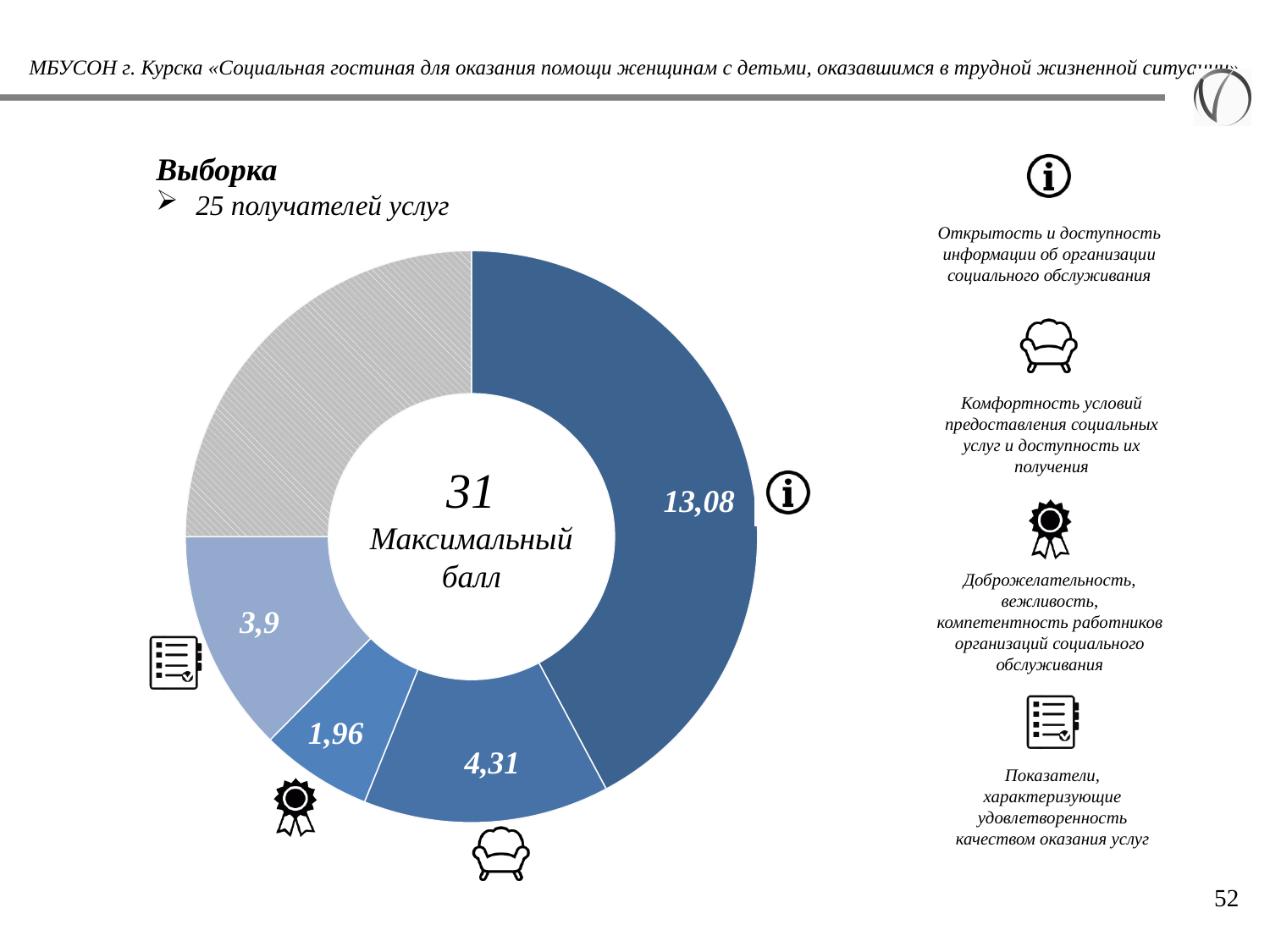
What value is shown on the segment marked with the medal icon (Доброжелательность, вежливость, компетентность работников)? 1,96 Which is larger: the value for the checklist-icon segment (3,9) or the medal-icon segment (1,96)? 3,9 (checklist-icon segment) Which labeled segment of the donut chart has the lowest value? 1,96 (Доброжелательность, вежливость, компетентность работников) What value is shown on the segment marked with the checklist icon (Показатели, характеризующие удовлетворенность качеством оказания услуг)? 3,9 Which labeled segment of the donut chart has the highest value? 13,08 (Открытость и доступность информации) What is the difference between the values 13,08 and 4,31 on the donut chart? 8,77 How many segments of the donut chart have a printed value label? 4 What value is shown on the largest dark blue segment of the donut chart (marked with the information icon)? 13,08 What value is shown on the segment marked with the armchair icon (Комфортность условий предоставления социальных услуг)? 4,31 According to the slide, how many service recipients were in the sample (Выборка)? 25 получателей услуг What type of chart is shown on the slide? Donut (pie) chart What number and text are shown in the center of the donut chart? 31 Максимальный балл